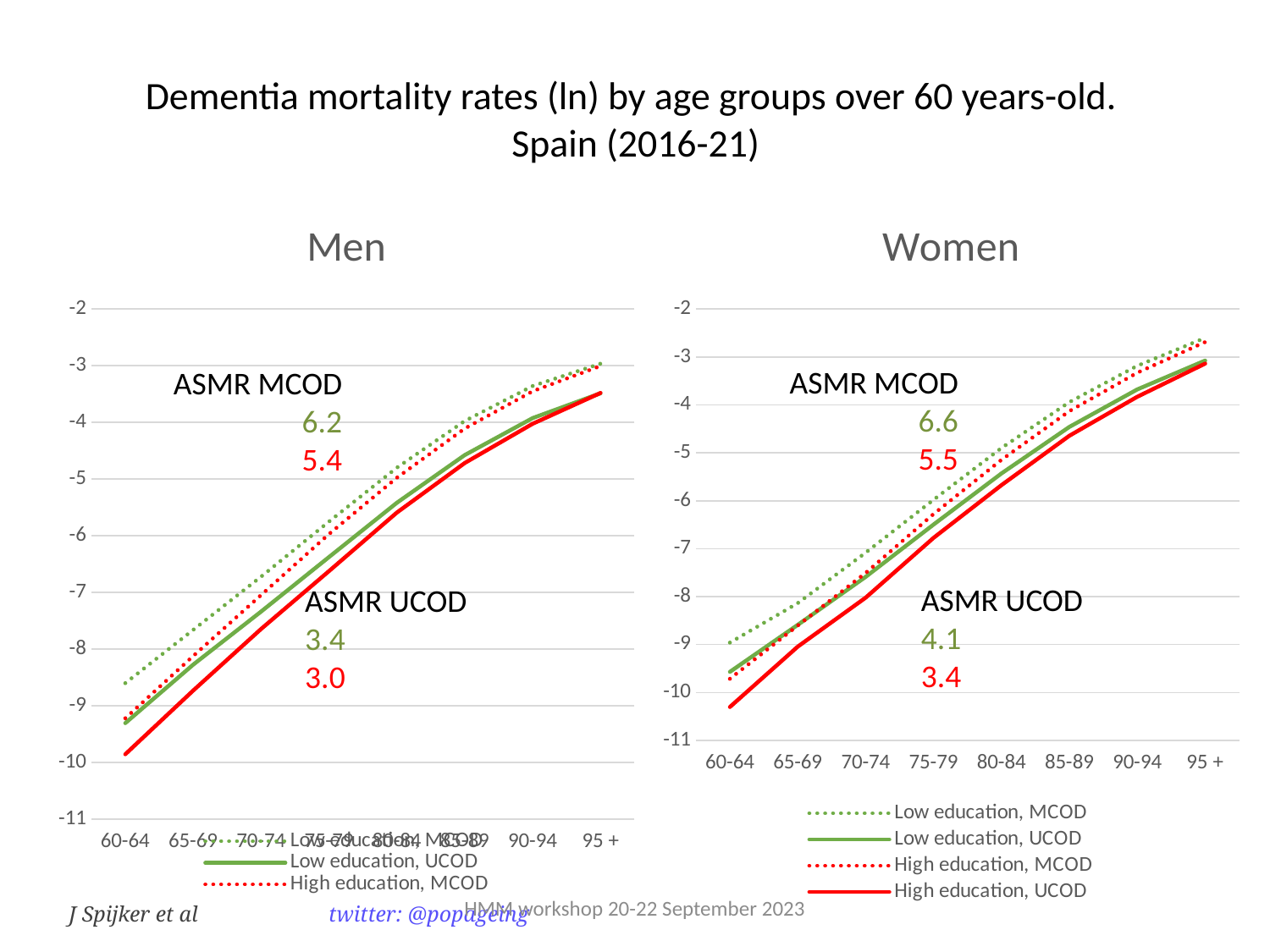
In the Men chart, is the value for High education, UCOD at 95+ greater or less than -3? less How many series does the legend of the Women chart list? 4 What type of chart is used for the Men and Women panels on this slide? line chart In the Women chart, is the value for High education, UCOD at 60-64 greater or less than -10? less In the Women chart, at age 60-64, is Low education, UCOD higher or lower than High education, UCOD? higher What ASMR MCOD value is printed in green on the Men chart? 6.2 In the Men chart, which series has the lowest value at age 60-64? High education, UCOD What ASMR UCOD value is printed in red on the Women chart? 3.4 In the Women chart, do the mortality rates rise or fall as age increases from 60-64 to 95+? rise In the Men chart, is the value for High education, UCOD at 60-64 greater or less than -9? less In the Men chart, which series has the highest value at age 60-64? Low education, MCOD How many age groups are shown on the x axis of the Men chart? 8